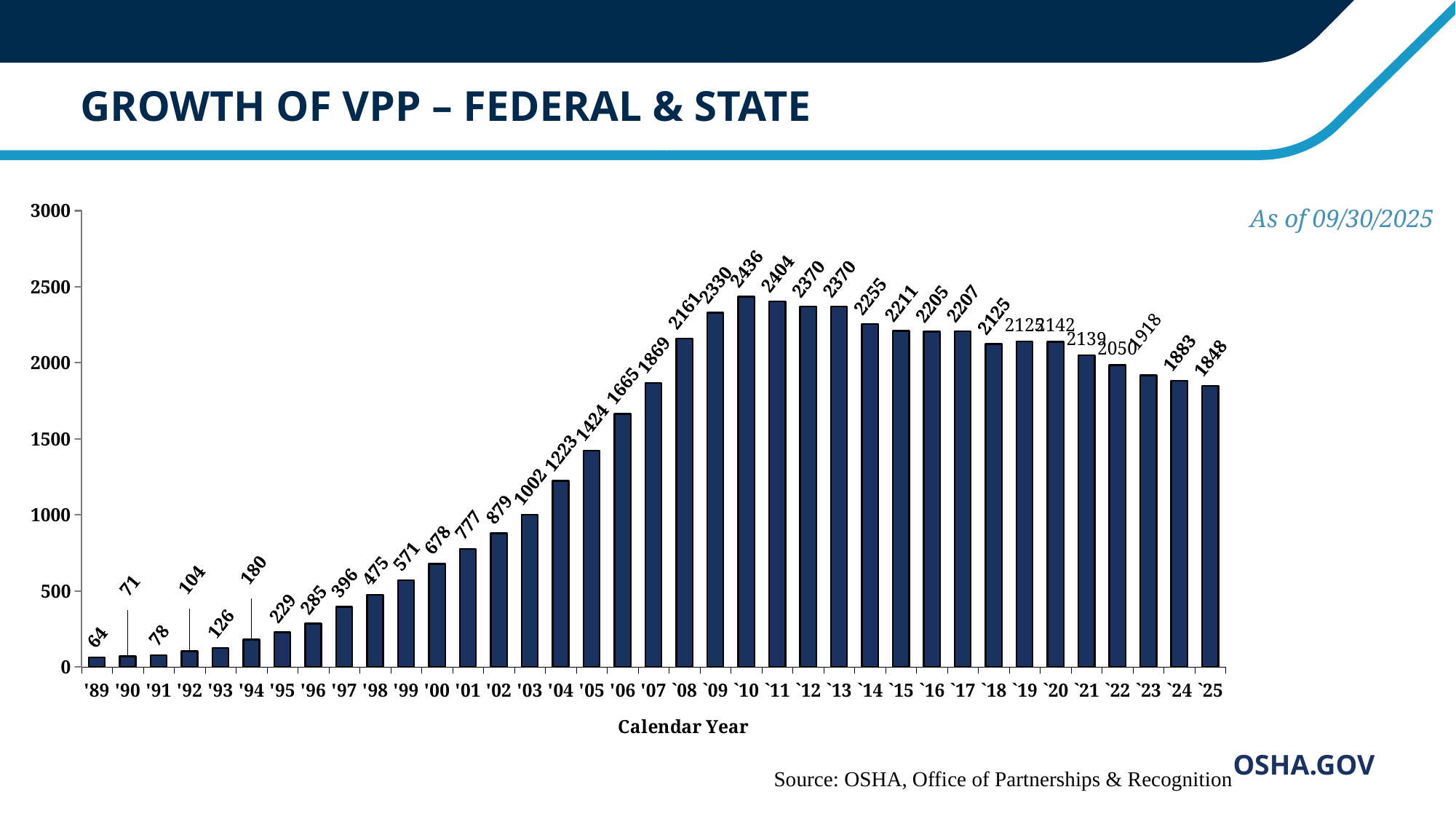
Do the values rise or fall from '89 to '10? rise Which is larger, the value for '05 or the value for '06? '06 Is the value for '21 greater or less than 2000? greater What is the difference between the values for '10 and '25? 588 How many years are shown on the x axis? 37 What is the value for '10? 2436 Which year has the highest value? '10 What kind of chart is this? bar chart What is the value for '00? 678 What is the difference between the values for '24 and '25? 35 What is the value for '89? 64 Which year has the lowest value? '89